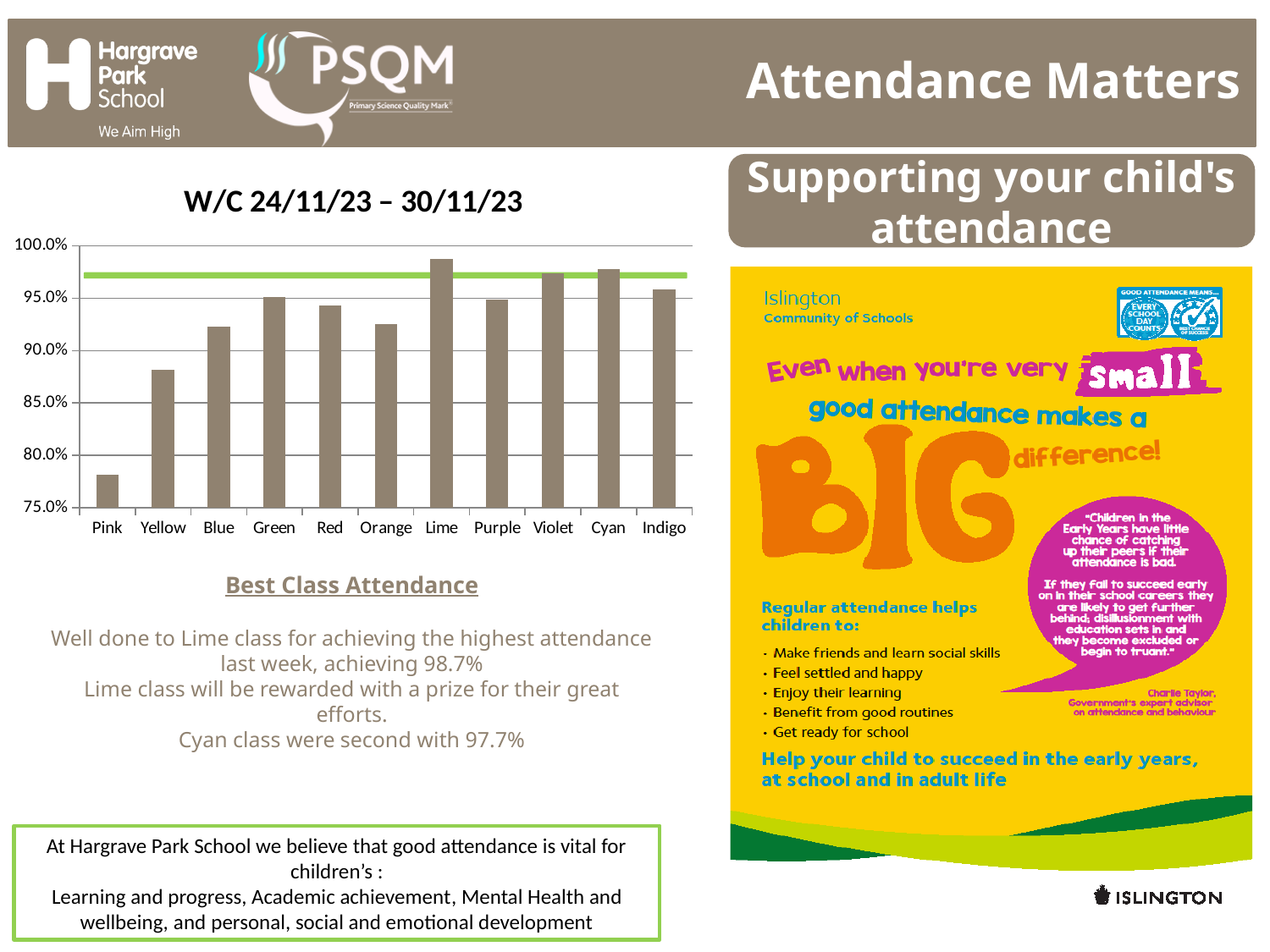
According to the slide, what attendance did Lime class achieve? 98.7% Is the attendance for Pink class greater or less than 80.0%? less Which class has the highest attendance in the chart? Lime According to the slide, what attendance did Cyan class achieve? 97.7% Is the attendance for Yellow class greater or less than 85.0%? greater Which class has higher attendance, Yellow or Blue? Blue What is the title of the chart? W/C 24/11/23 – 30/11/23 What kind of chart is shown on the slide? bar chart What is the difference between Lime class's attendance and Cyan class's attendance? 1.0% Is the attendance for Blue class greater or less than 95.0%? less How many classes are shown on the x axis of the chart? 11 Which class has the lowest attendance in the chart? Pink